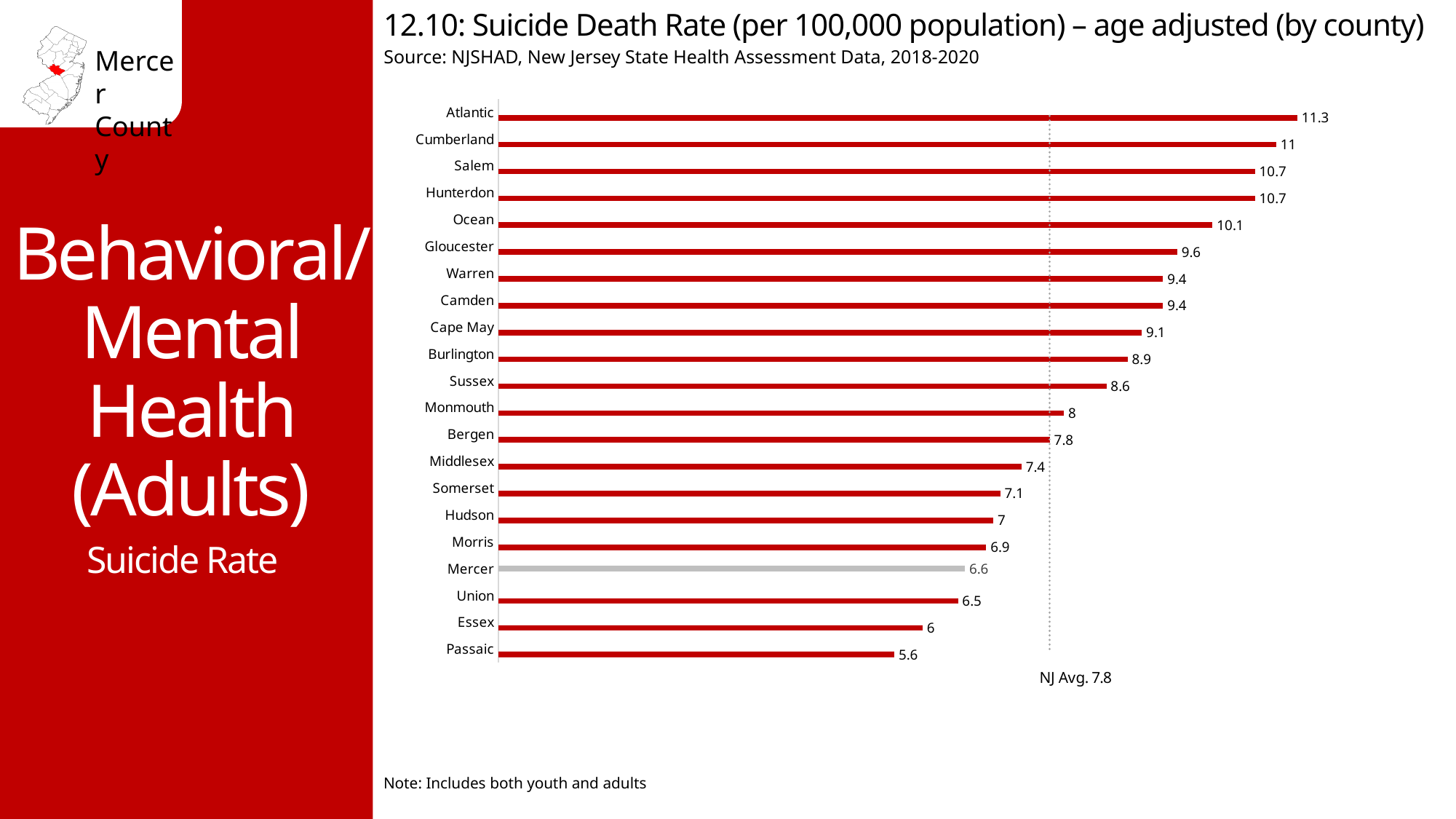
What type of chart is shown on the slide? Bar chart What is the difference between the suicide death rate of Mercer County and the NJ average? 1.2 What is the suicide death rate for Mercer County? 6.6 Which county has the highest suicide death rate? Atlantic What is the suicide death rate for Passaic County? 5.6 What is the NJ average suicide death rate shown by the dotted line? 7.8 How many counties are shown in the chart? 21 Which county has the lowest suicide death rate? Passaic Which county's bar is shown in gray instead of red? Mercer Which has a higher suicide death rate, Ocean or Gloucester? Ocean What is the difference between the suicide death rates of Atlantic and Passaic counties? 5.7 What is the suicide death rate for Atlantic County? 11.3